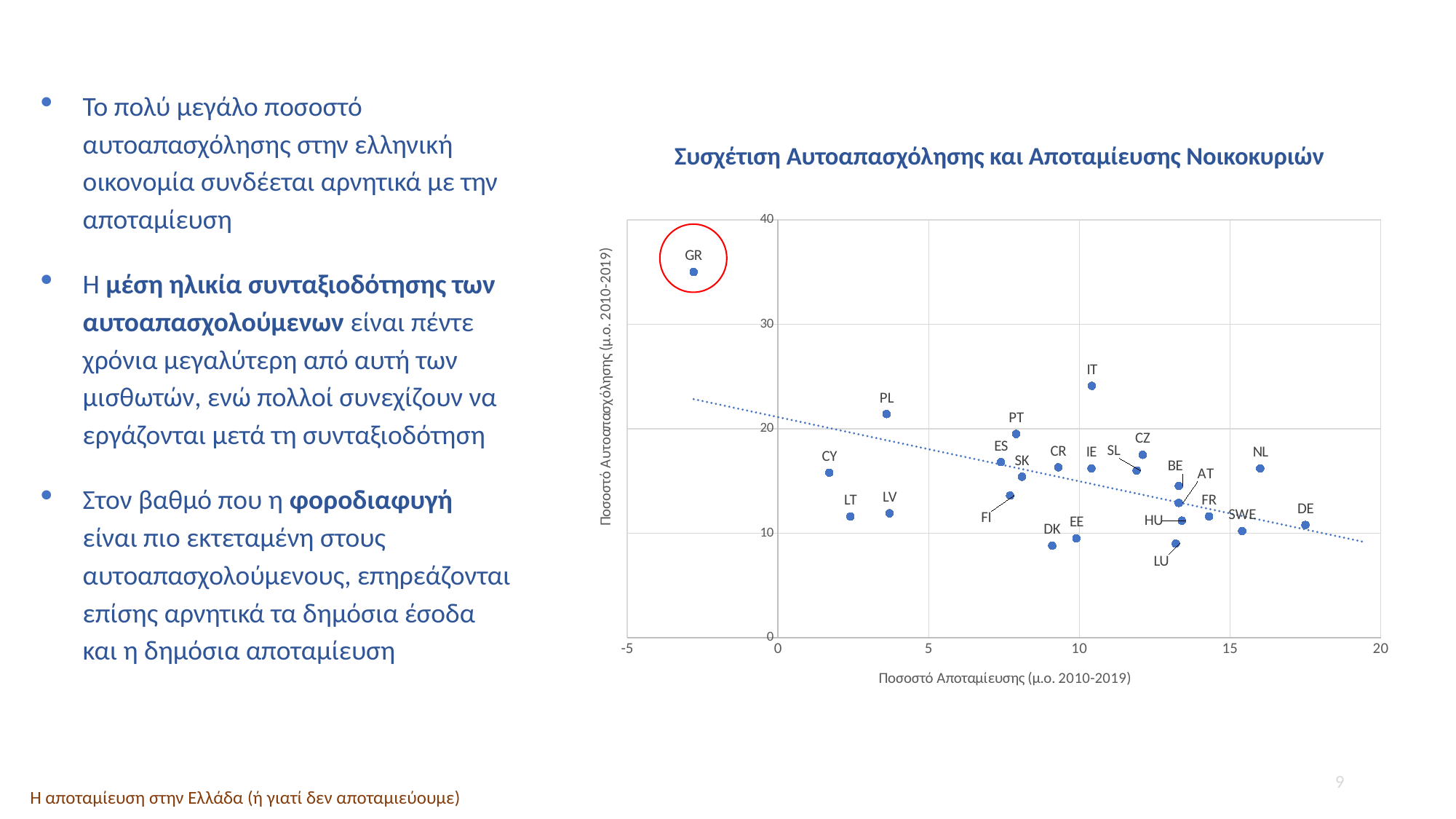
Which has the higher self-employment rate (y-axis), IT or PL? IT According to the dotted trend line, does the self-employment rate rise or fall as the savings rate increases? fall Which has the higher savings rate (x-axis), DE or NL? DE What kind of chart is shown on the slide? scatter chart Is the savings rate (x-axis) for GR greater or less than 0? less Is the self-employment rate (y-axis) for IT greater or less than 20? greater Which country has the lowest savings rate (x-axis) in the chart? GR Which country has the highest self-employment rate (y-axis) in the chart? GR Is the self-employment rate (y-axis) for GR greater or less than 30? greater Which country has the highest savings rate (x-axis) in the chart? DE Which country's point is circled in red on the chart? GR